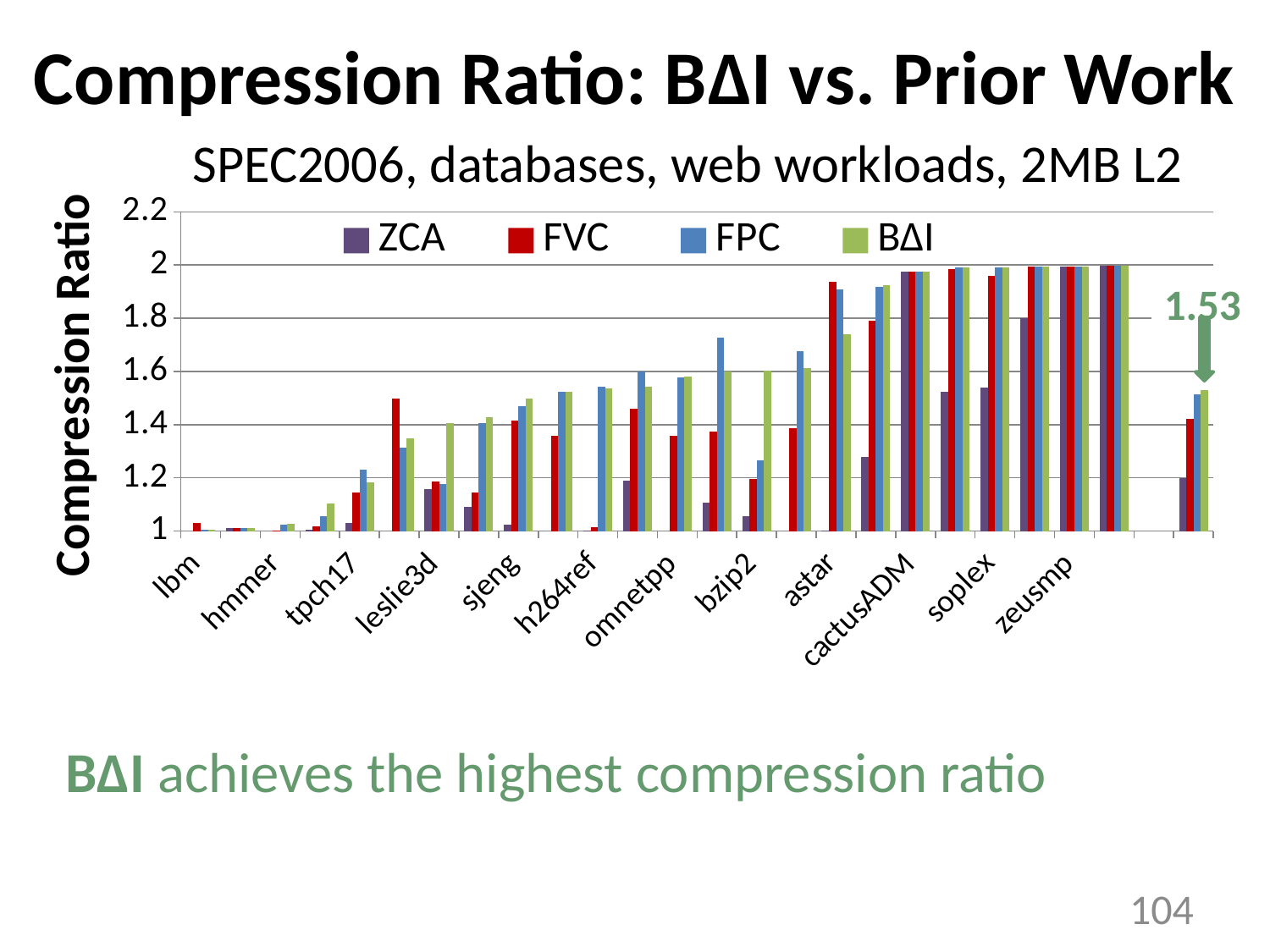
Is the BΔI value for zeusmp greater or less than 1.8? greater What kind of chart is shown on the slide? bar chart Is the ZCA value for bzip2 greater or less than 1.2? less Is the BΔI value for leslie3d greater or less than 1.2? greater How many series does the chart legend list? 4 Do the compression ratios generally rise or fall moving from left to right across the labeled workloads? rise For leslie3d, which is larger: the ZCA value or the BΔI value? BΔI What are the four series named in the chart legend? ZCA, FVC, FPC, BΔI What value is annotated with an arrow above the rightmost group of bars? 1.53 What is the label on the vertical axis of the chart? Compression Ratio For astar, which is larger: the FVC value or the BΔI value? FVC